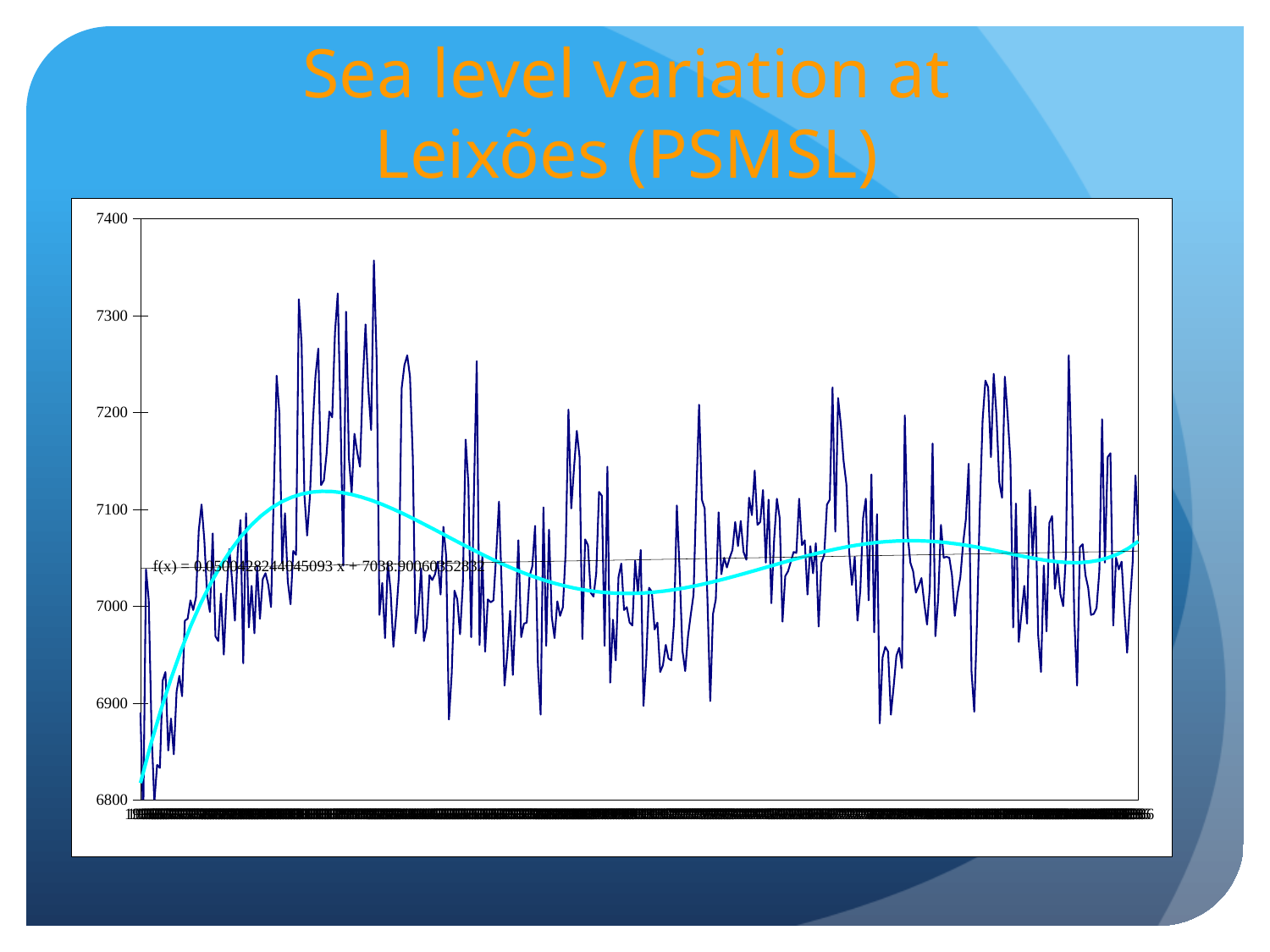
Is the lowest point of the dark blue data line greater or less than 6900? less What colour is the smoothed curve drawn over the jagged data line? cyan Is the highest peak of the dark blue data line greater or less than 7300? greater Is the highest point of the cyan smoothed curve greater or less than 7000? greater Which line reaches a higher peak, the dark blue data line or the cyan smoothed curve? the dark blue data line What kind of chart is shown on the slide? line chart What is the title of the chart? Sea level variation at Leixões (PSMSL) Does the cyan smoothed curve rise or fall over its first section at the left of the chart? rise